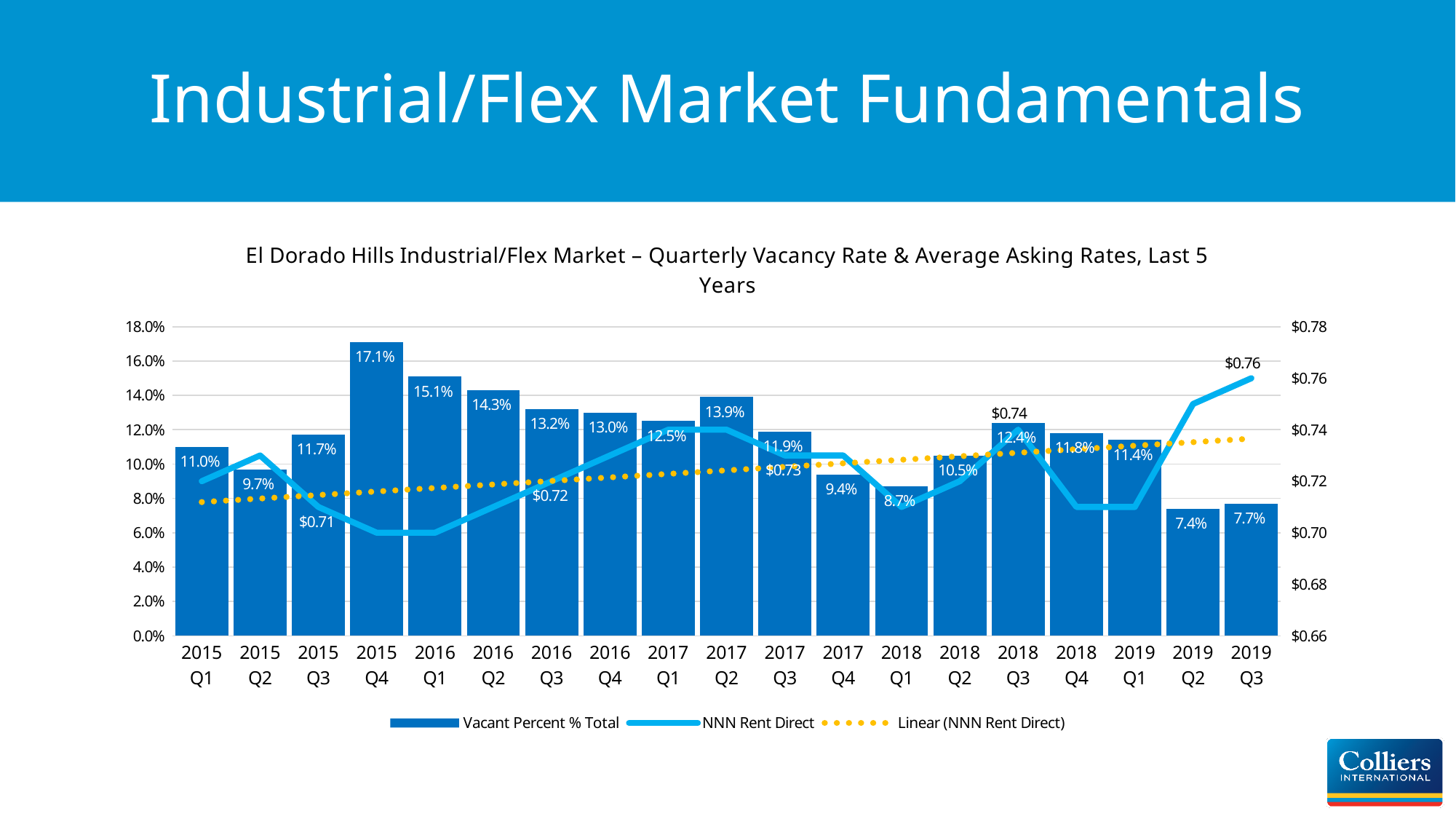
What is the NNN Rent Direct value labelled for 2019 Q3? $0.76 Is the NNN Rent Direct value for 2015 Q4 greater or less than $0.72? less What is the Vacant Percent % Total for 2018 Q1? 8.7% Which quarter has the highest Vacant Percent % Total? 2015 Q4 How many series does the legend list? 3 Which quarter has the lowest Vacant Percent % Total? 2019 Q2 What kind of chart is shown on the slide? Combination bar and line chart How many quarters are shown on the x axis? 19 Which has the higher Vacant Percent % Total, 2016 Q1 or 2017 Q2? 2016 Q1 What is the Vacant Percent % Total for 2015 Q4? 17.1% What is the difference between the NNN Rent Direct labelled for 2018 Q3 and for 2015 Q3? $0.03 What is the difference between the Vacant Percent % Total for 2015 Q4 and 2019 Q2? 9.7 percentage points